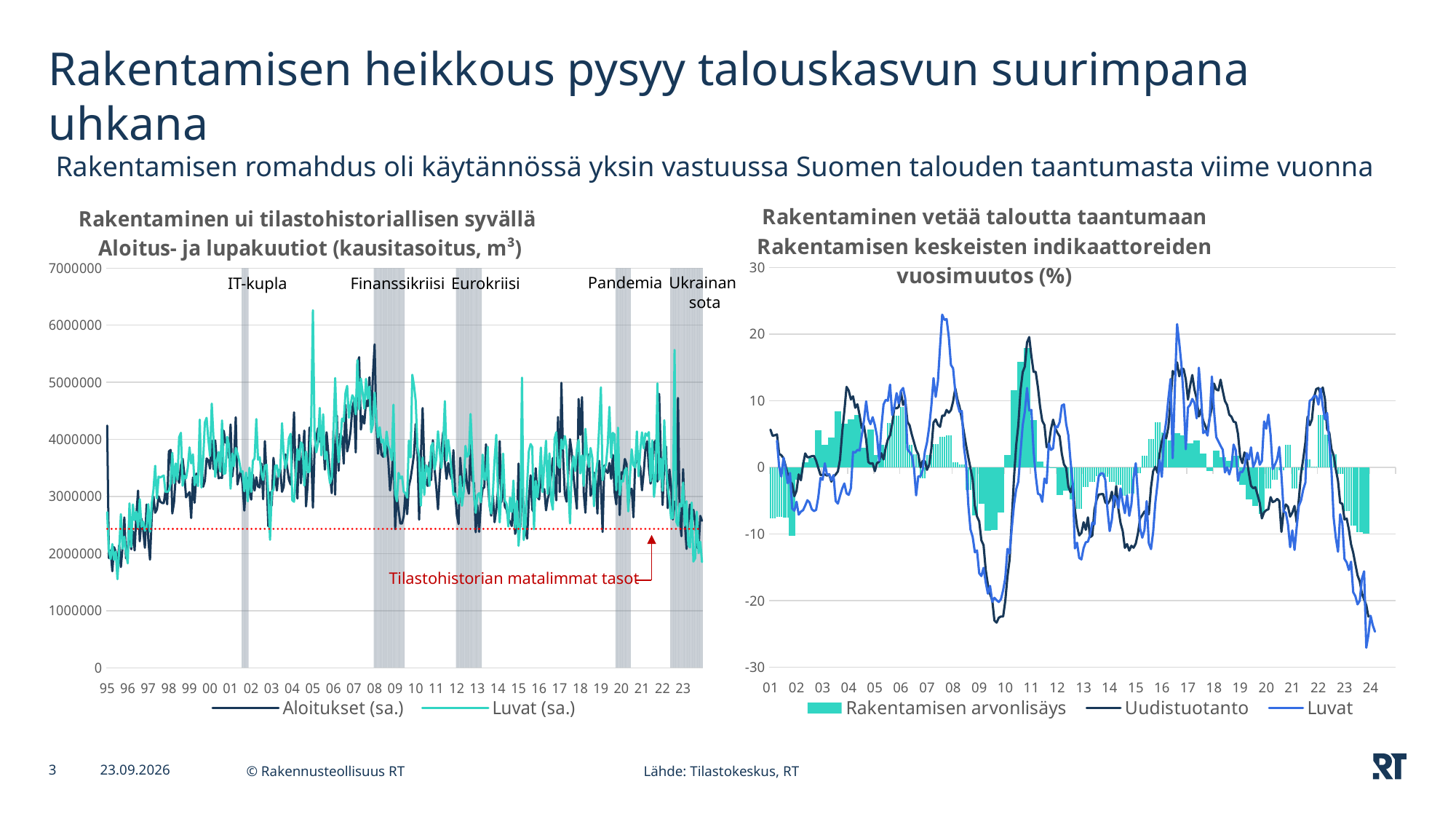
In the left chart (Aloitus- ja lupakuutiot), what are the two legend entries? Aloitukset (sa.) and Luvat (sa.) In the right chart (Rakentamisen keskeisten indikaattoreiden vuosimuutos), which series is drawn as bars? Rakentamisen arvonlisäys In the right chart (Rakentamisen keskeisten indikaattoreiden vuosimuutos), is the value of Luvat at the end of 2024 greater or less than -20? less In the left chart (Aloitus- ja lupakuutiot), is the value of Aloitukset (sa.) at the end of 2023 greater or less than 3000000? less In the right chart (Rakentamisen keskeisten indikaattoreiden vuosimuutos), how many series does the legend list? 3 In the left chart (Aloitus- ja lupakuutiot), how many shaded crisis periods are labelled above the plot? 5 What kind of chart is the left chart (Aloitus- ja lupakuutiot)? line chart In the left chart (Aloitus- ja lupakuutiot), is the peak value of Luvat (sa.) around 2005 greater or less than 6000000? greater In the left chart (Aloitus- ja lupakuutiot), do the values of Aloitukset (sa.) rise or fall from 2021 to 2023? fall In the right chart (Rakentamisen keskeisten indikaattoreiden vuosimuutos), do the values of Uudistuotanto rise or fall from 2022 to 2024? fall In the left chart (Aloitus- ja lupakuutiot), how many series does the legend list? 2